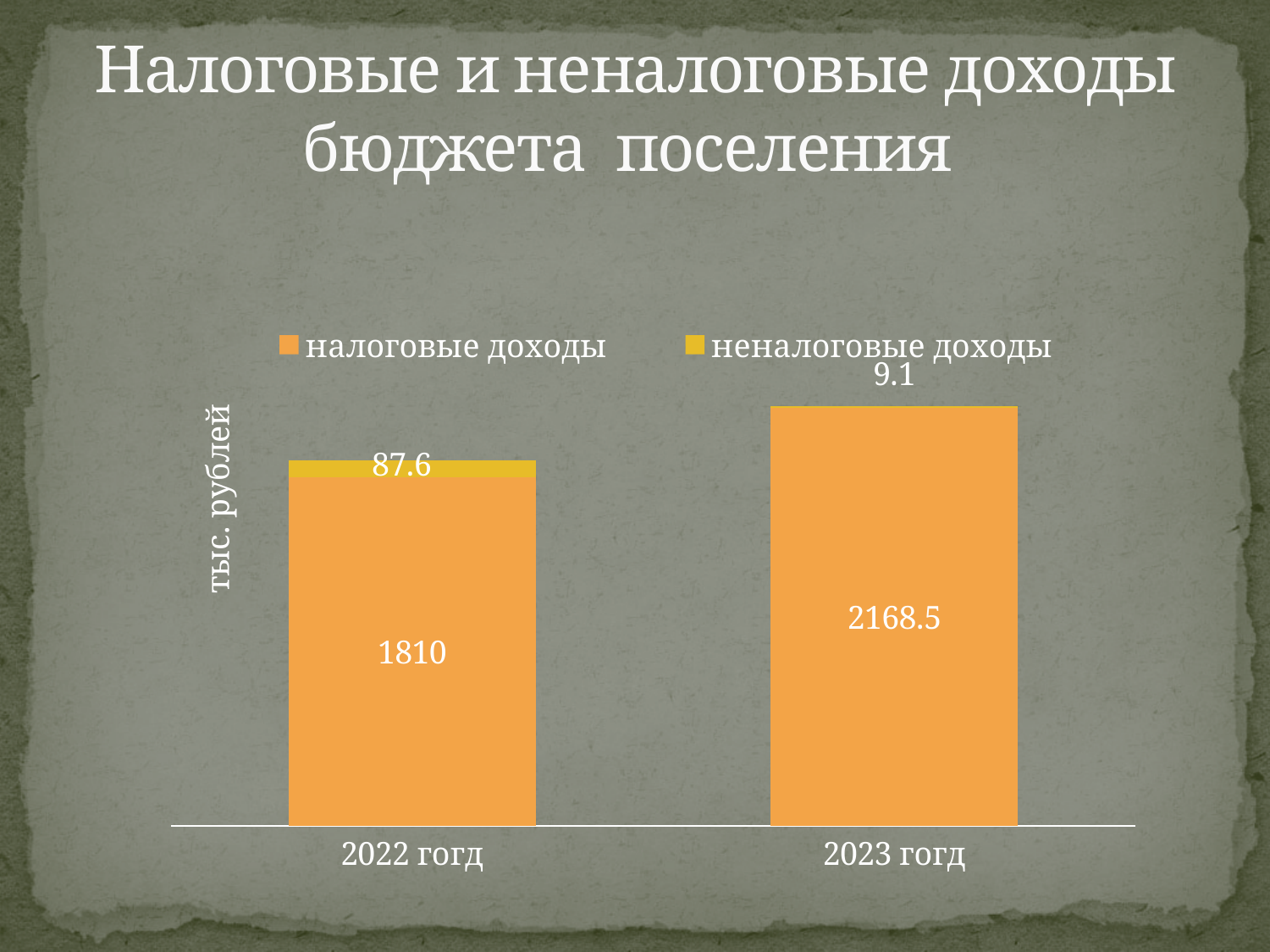
Which year has the higher value of налоговые доходы? 2023 гогд Which year has the lower value of неналоговые доходы? 2023 гогд What is the value of неналоговые доходы for 2023 гогд? 9.1 What kind of chart is shown on the slide? Stacked bar chart What is the difference in неналоговые доходы between 2022 гогд and 2023 гогд? 78.5 What is the total of the stacked bar for 2022 гогд? 1897.6 What is the value of налоговые доходы for 2023 гогд? 2168.5 What is the total of the stacked bar for 2023 гогд? 2177.6 How many series does the legend list? 2 What is the difference in налоговые доходы between 2023 гогд and 2022 гогд? 358.5 What is the value of налоговые доходы for 2022 гогд? 1810 What is the value of неналоговые доходы for 2022 гогд? 87.6